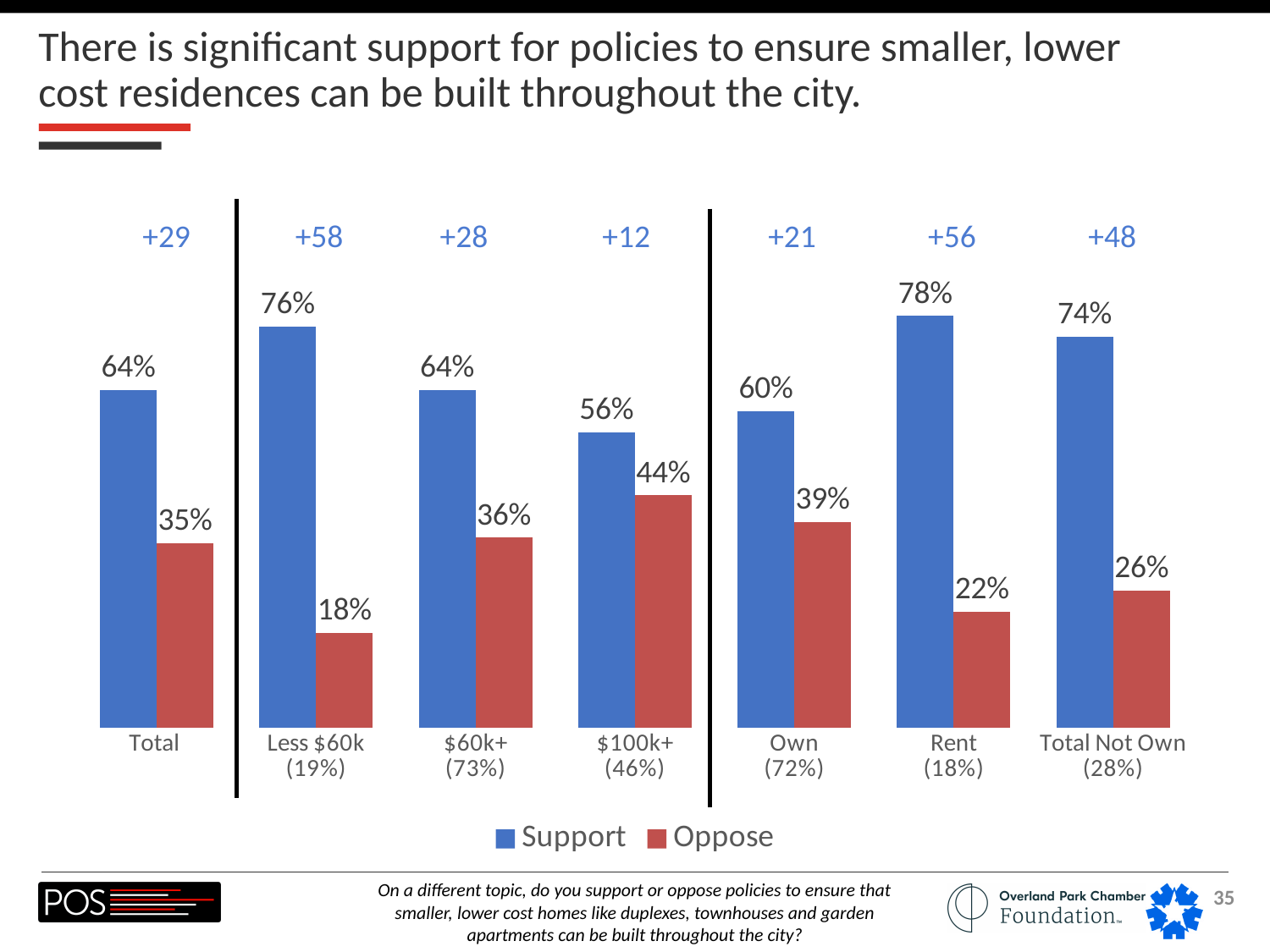
What kind of chart is shown on the slide? Bar chart How many series does the legend list? 2 What percentage of the Total group supports the policies? 64% What is the difference between Support and Oppose for the $100k+ group? 12 Which category has the lowest Oppose value? Less $60k What is the Oppose value for the Less $60k group? 18% How many categories are shown on the x axis? 7 Which category has the highest Support value? Rent What is the Support value for the Rent group? 78% Which colour represents the Oppose series? Red What is the net support figure shown above the Less $60k group? +58 Which is larger, the Oppose value for Own or the Oppose value for Total Not Own? Own